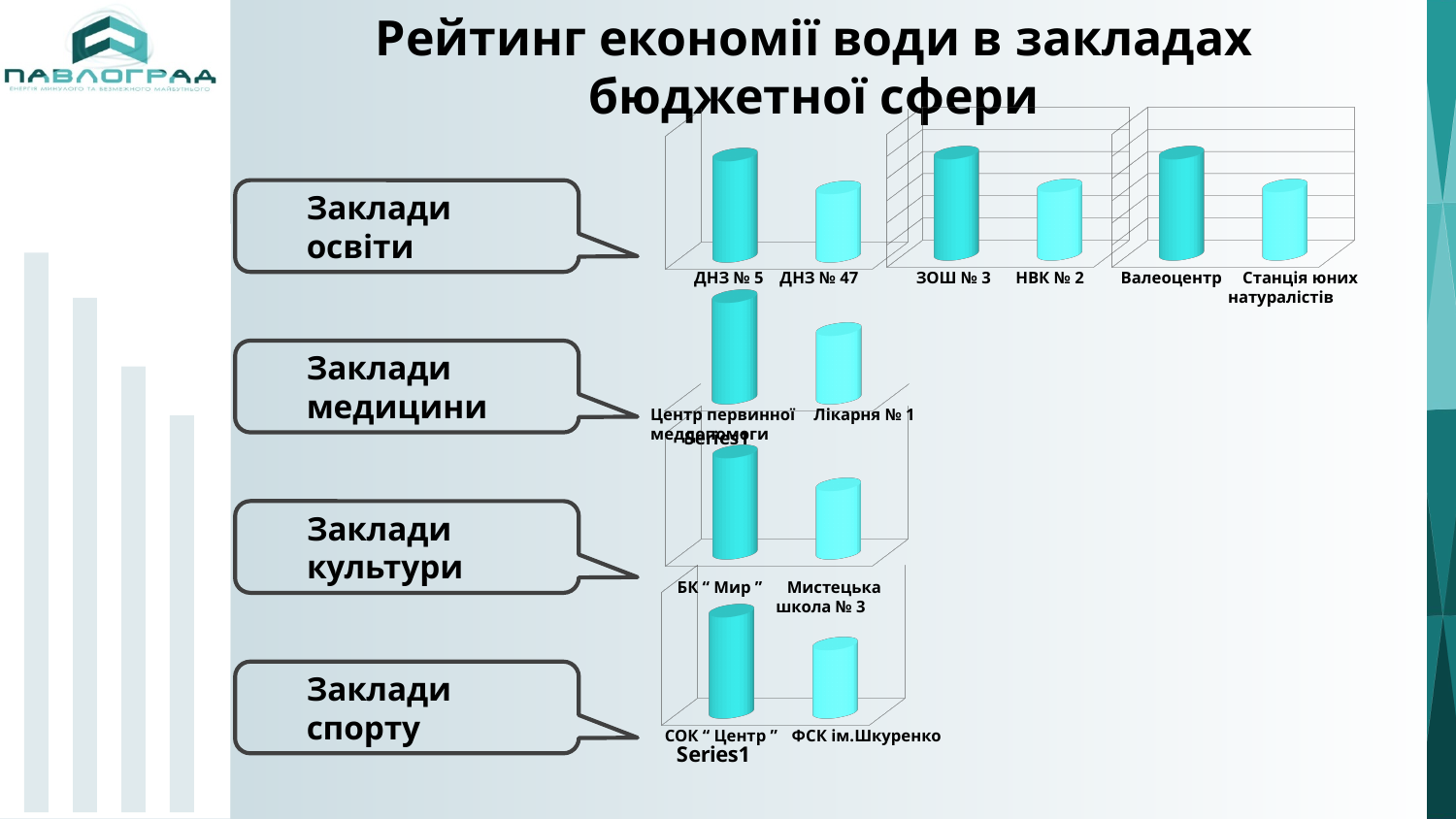
How many categories are shown in the 'Заклади спорту' chart? 2 What kind of chart is used for the 'Заклади освіти' (education) section? bar chart In the chart with ДНЗ № 5 and ДНЗ № 47, which category has the taller bar? ДНЗ № 5 What series name is printed below the 'Заклади спорту' chart? Series1 In the chart with Валеоцентр and Станція юних натуралістів, which category has the higher value? Валеоцентр In the 'Заклади спорту' chart, which category has the lowest value? ФСК ім.Шкуренко What is the title of the slide containing the charts? Рейтинг економії води в закладах бюджетної сфери In the chart with ЗОШ № 3 and НВК № 2, which category has the lower value? НВК № 2 In the 'Заклади медицини' chart, is the bar for Центр первинної меддопомоги taller or shorter than the bar for Лікарня № 1? taller How many separate charts are shown in the 'Заклади освіти' row? 3 How many categories are shown in the 'Заклади медицини' chart? 2 In the 'Заклади культури' chart, which category has the highest value? БК “ Мир ”